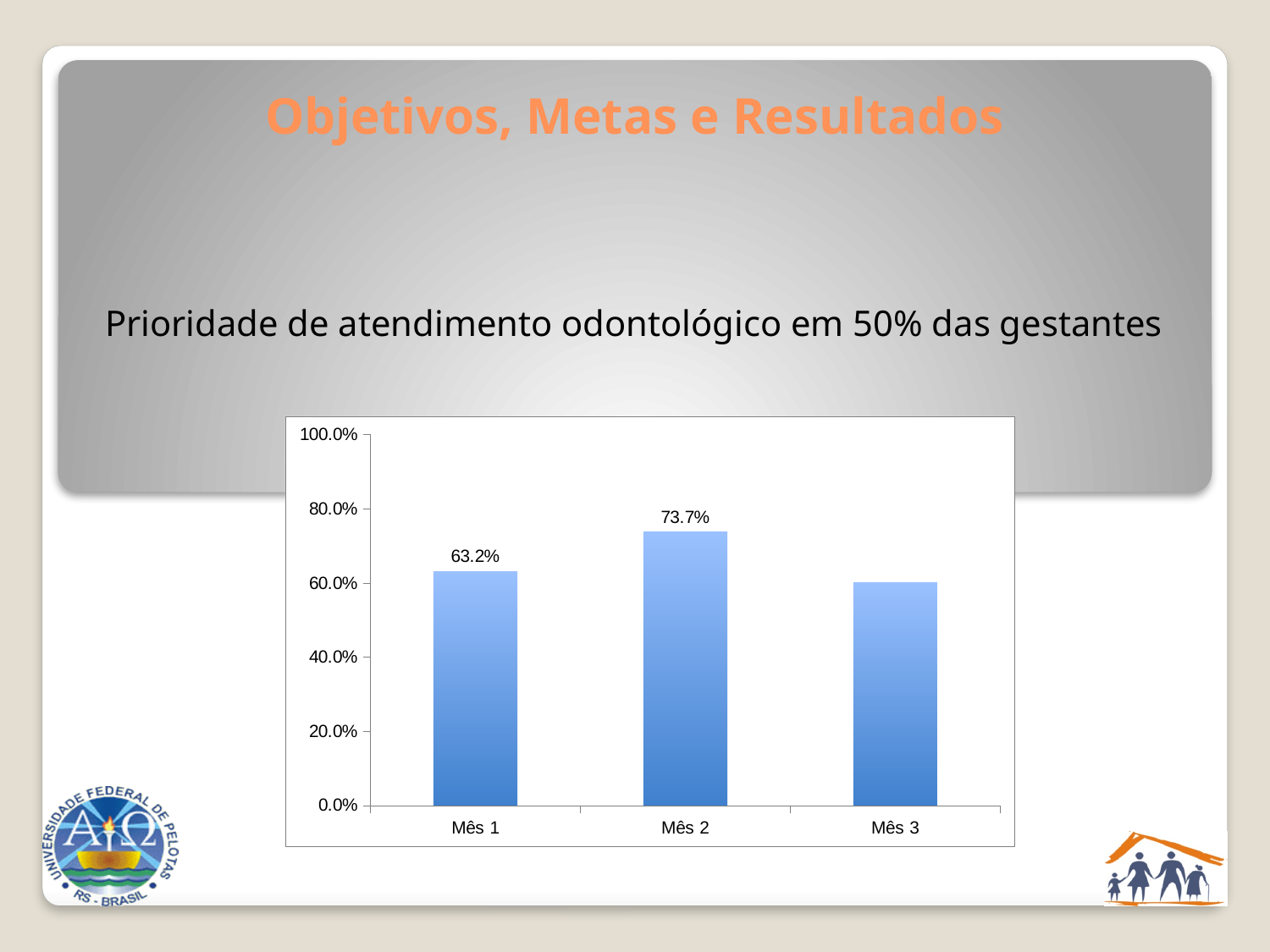
What is the difference between the values for Mês 2 and Mês 1? 10.5% What kind of chart is shown on the slide? bar chart What is the value for Mês 1? 63.2% Is the value for Mês 3 greater or less than 40.0%? greater Which is larger, the value for Mês 1 or the value for Mês 2? Mês 2 Is the value for Mês 3 greater or less than 80.0%? less What is the highest value shown on the y axis? 100.0% Does the value rise or fall from Mês 1 to Mês 2? rise What is the value for Mês 2? 73.7% How many categories are shown on the x axis? 3 Which month has the highest value? Mês 2 What is the label of the third category on the x axis? Mês 3